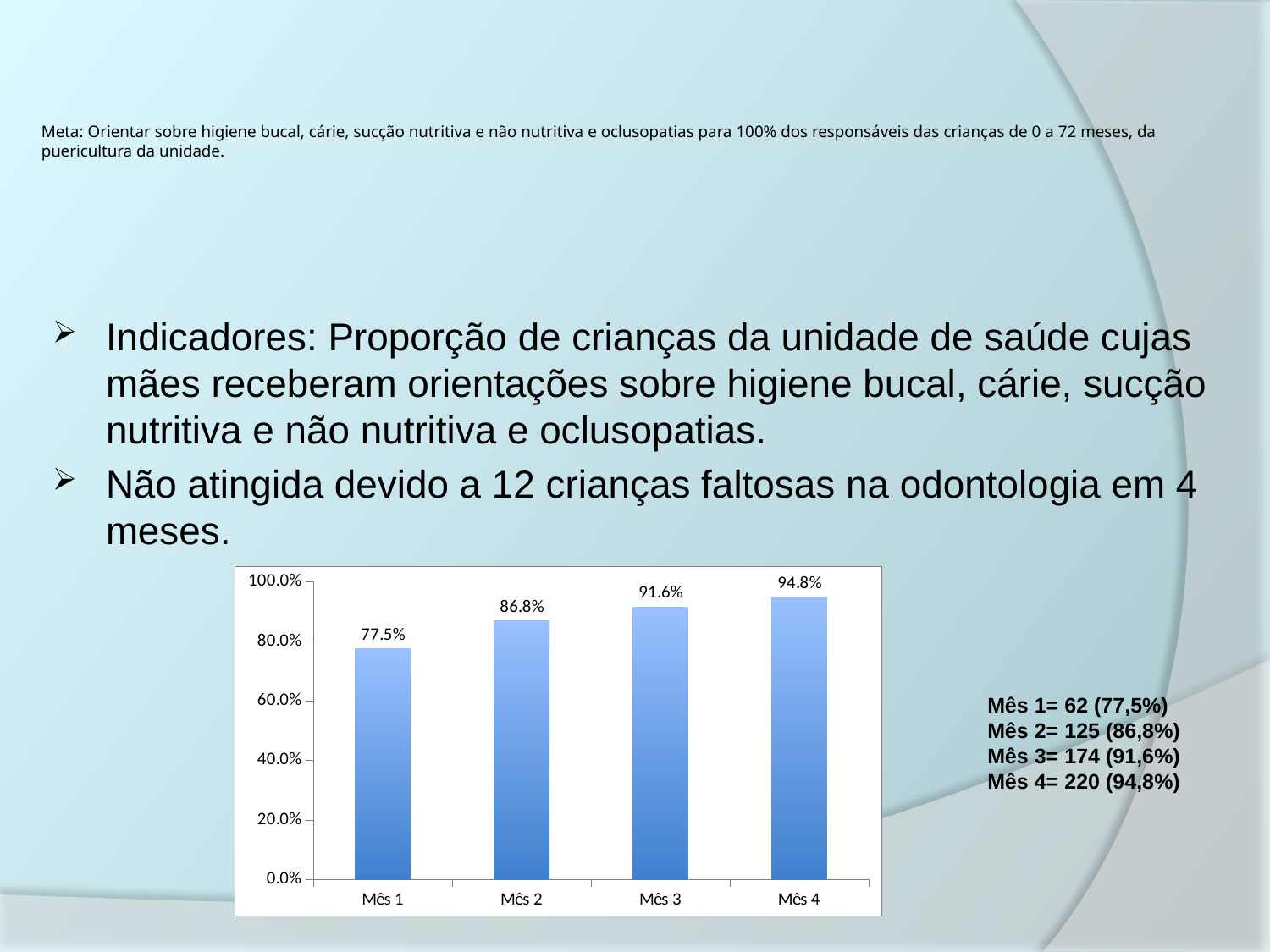
What is the difference between the values for Mês 2 and Mês 1? 9.3% How many categories are shown on the x axis? 4 What is the difference between the values for Mês 4 and Mês 1? 17.3% What is the value for Mês 2? 86.8% What kind of chart is shown on the slide? bar chart What is the value for Mês 3? 91.6% Which month has the highest value? Mês 4 What is the value for Mês 1? 77.5% Which is larger, the value for Mês 2 or the value for Mês 3? Mês 3 What is the value for Mês 4? 94.8% Which month has the lowest value? Mês 1 Is the value for Mês 1 greater or less than 80.0%? less